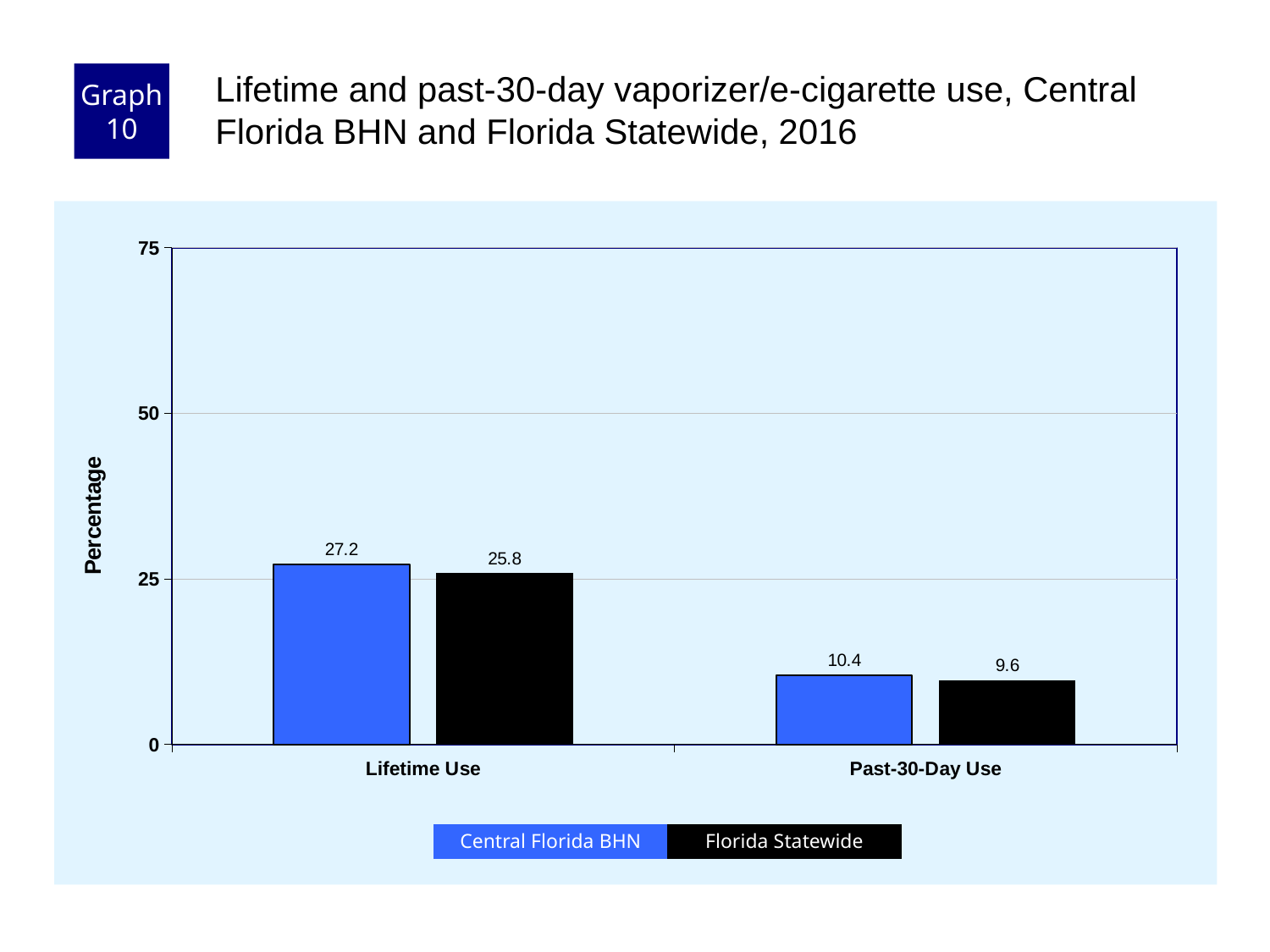
What kind of chart is shown on the slide? Bar chart Which bar has the lowest value on the chart? Florida Statewide, Past-30-Day Use What is the Lifetime Use value for Florida Statewide? 25.8 What is the Past-30-Day Use value for Florida Statewide? 9.6 What is the difference between the Lifetime Use and Past-30-Day Use values for Central Florida BHN? 16.8 Which bar has the highest value on the chart? Central Florida BHN, Lifetime Use What is the difference between the Central Florida BHN and Florida Statewide values for Lifetime Use? 1.4 For Past-30-Day Use, which is larger: Central Florida BHN or Florida Statewide? Central Florida BHN What is the Lifetime Use value for Central Florida BHN? 27.2 Is the Lifetime Use value for Florida Statewide greater or less than 25? greater How many series does the legend list? 2 What is the Past-30-Day Use value for Central Florida BHN? 10.4